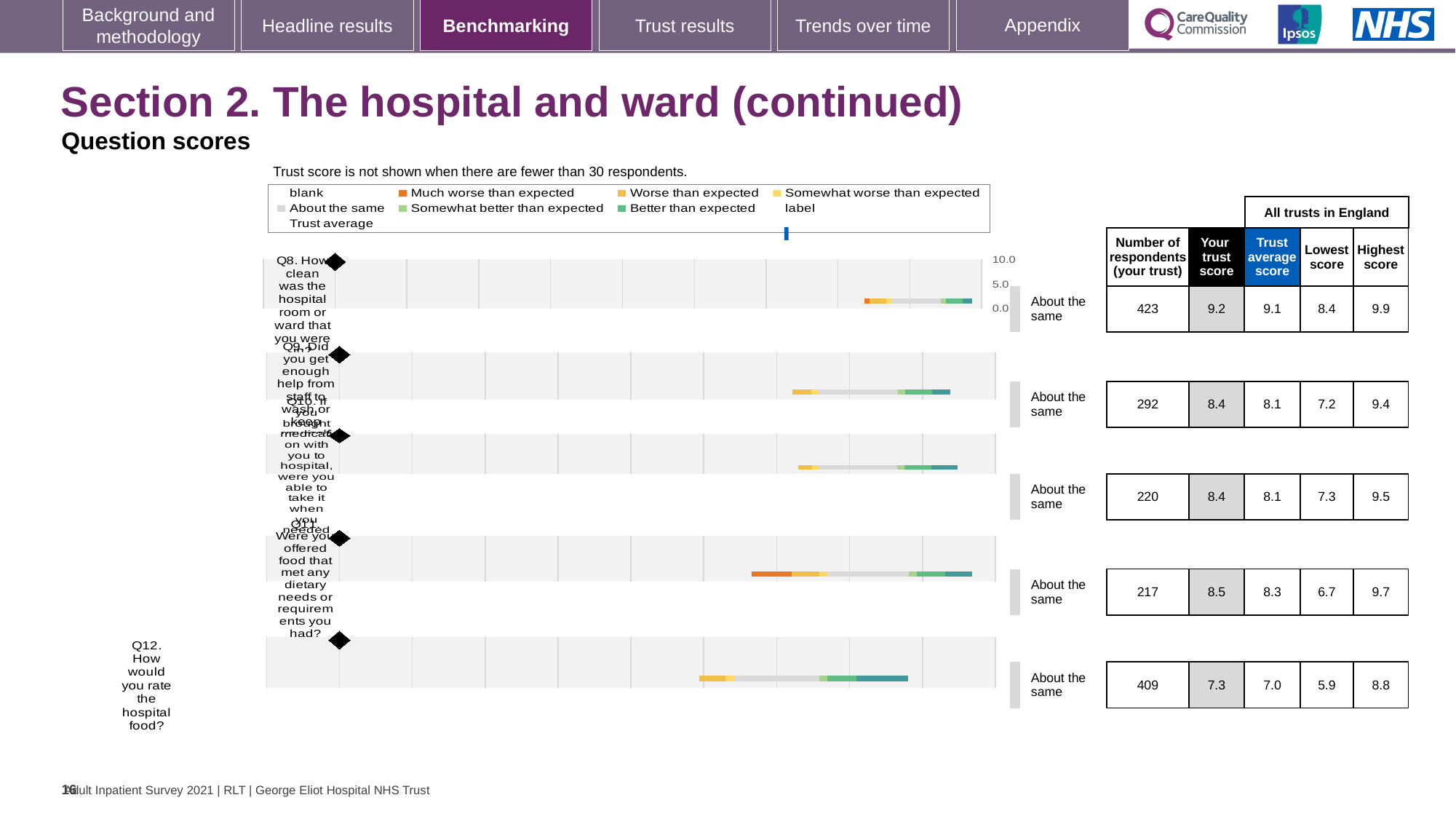
What is the trust average score for Q12 (How would you rate the hospital food)? 7.0 What is the trust score for Q8 (How clean was the hospital room or ward)? 9.2 What kind of chart is used to show the question scores for Q8 to Q12? bar chart What is the difference between the highest score and the lowest score for Q11? 3.0 How many respondents from the trust answered Q8? 423 Which question has the highest trust score? Q8 How many questions (bars) are plotted in the question scores chart? 5 Which question has the lowest trust score? Q12 Is the trust score for Q12 greater or less than 5.0? greater What benchmark category is shown next to every question in the chart? About the same What is the lowest score across all trusts in England for Q11 (dietary needs)? 6.7 Which is larger, the trust score for Q9 or the trust score for Q12? Q9